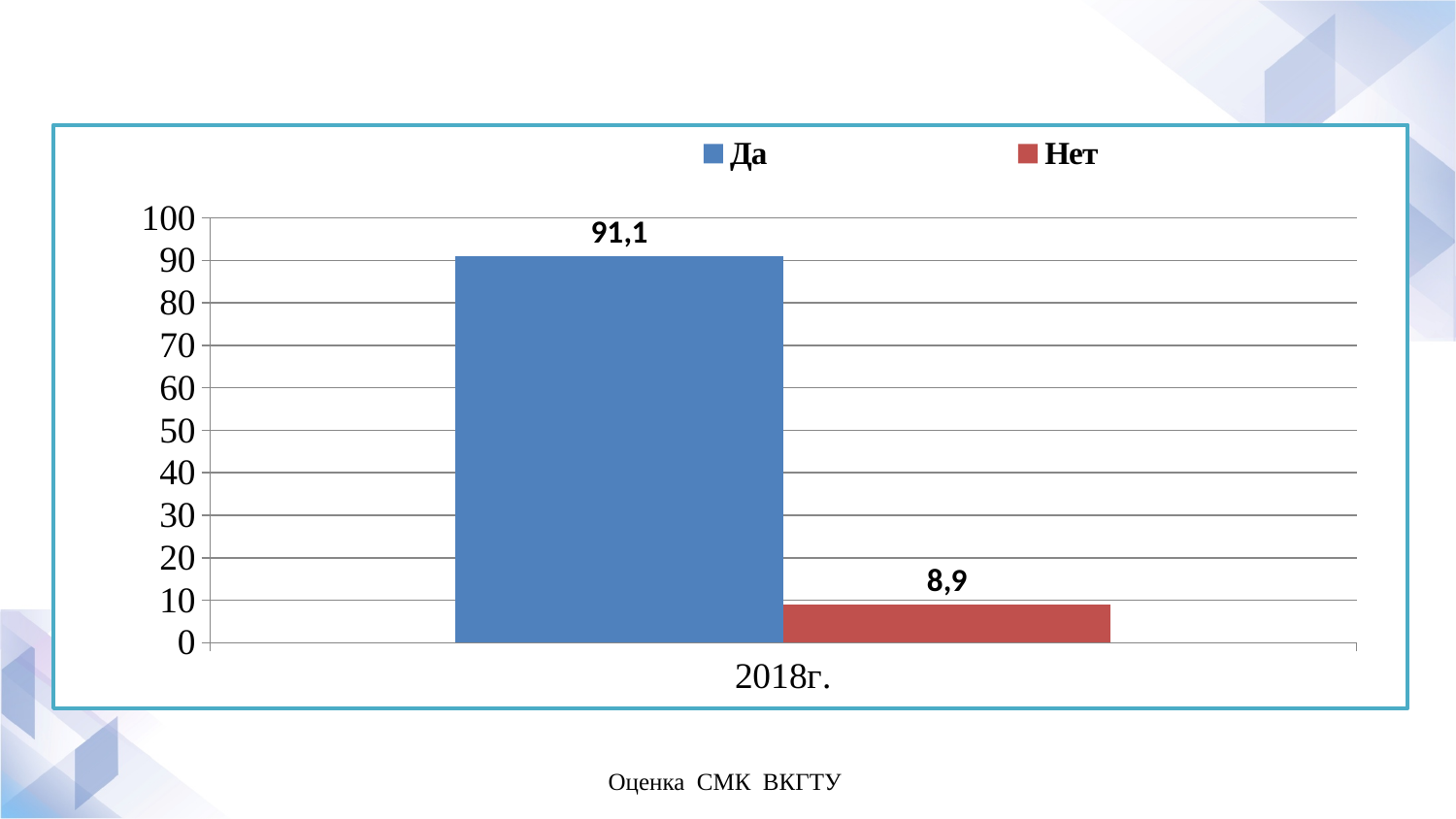
What is the category label on the x axis? 2018г. How many categories are shown on the x axis? 1 What kind of chart is shown on the slide? bar chart What is the value for "Нет" in 2018г.? 8,9 Which series has the higher value, "Да" or "Нет"? Да Is the value for "Нет" greater or less than 10? less What is the difference between the values for "Да" and "Нет"? 82,2 What colour is the bar for "Нет"? red Is the value for "Да" greater or less than 90? greater How many series does the legend list? 2 Which series has the lowest value on the chart? Нет What is the value for "Да" in 2018г.? 91,1